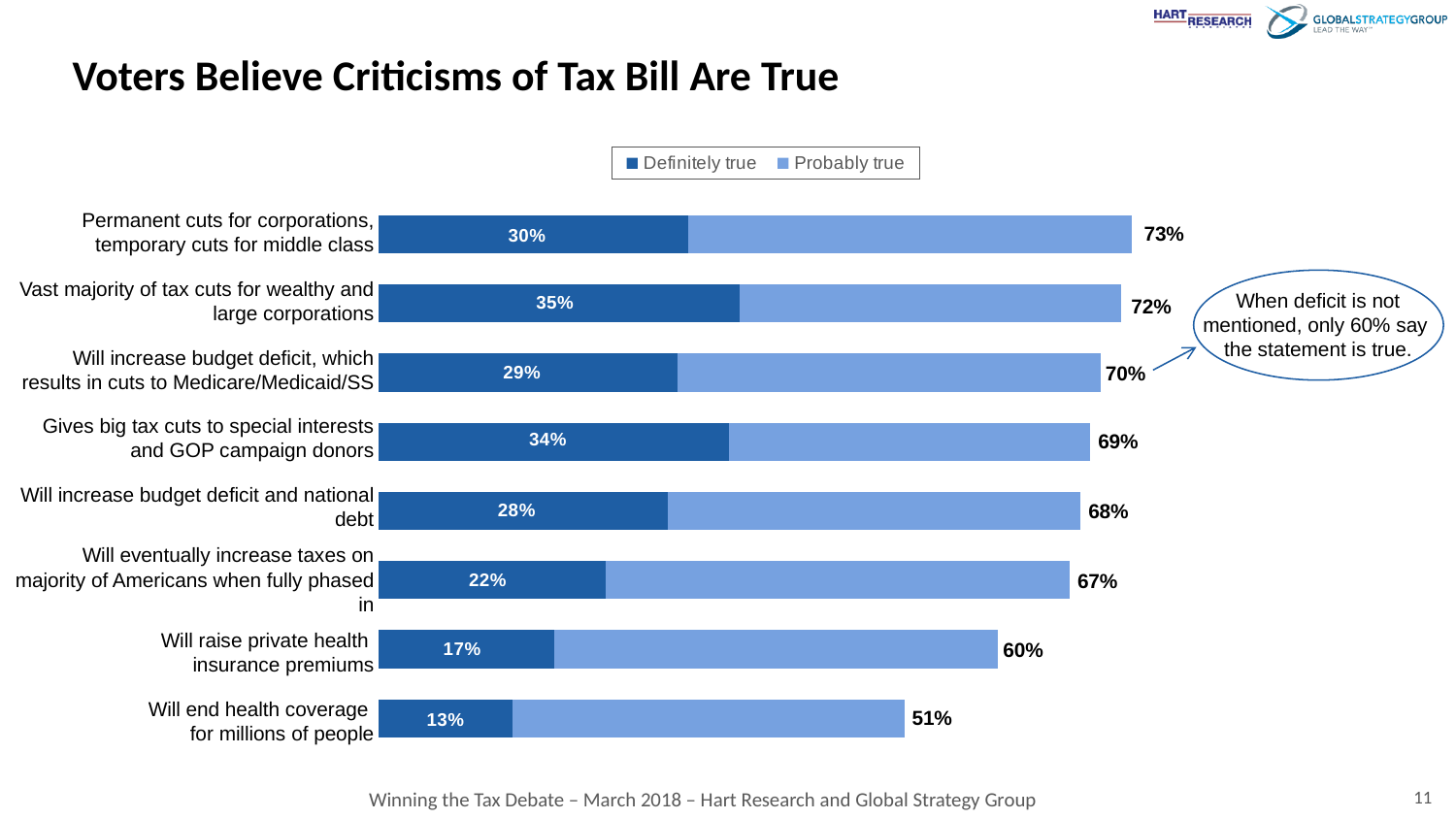
What is the difference between the total for 'Will increase budget deficit and national debt' and the total for 'Will end health coverage for millions of people'? 17 percentage points How many statements are shown in the chart? 8 According to the callout on the slide, what share of voters say the deficit statement is true when the deficit is not mentioned? 60% What percentage of voters say it is definitely true that the tax bill gives permanent cuts for corporations, temporary cuts for middle class? 30% What is the 'Definitely true' percentage for 'Will raise private health insurance premiums'? 17% How many series does the legend list? 2 Which statement has the highest combined share of voters saying it is definitely or probably true? Permanent cuts for corporations, temporary cuts for middle class What is the total share of voters who say it is definitely or probably true that the vast majority of tax cuts go to the wealthy and large corporations? 72% Which statement has the lowest combined share of voters saying it is definitely or probably true? Will end health coverage for millions of people Which statement has the highest 'Definitely true' percentage? Vast majority of tax cuts for wealthy and large corporations What type of chart is shown on the slide? Stacked bar chart Is the 'Definitely true' percentage larger for 'Gives big tax cuts to special interests and GOP campaign donors' or for 'Will increase budget deficit, which results in cuts to Medicare/Medicaid/SS'? Gives big tax cuts to special interests and GOP campaign donors